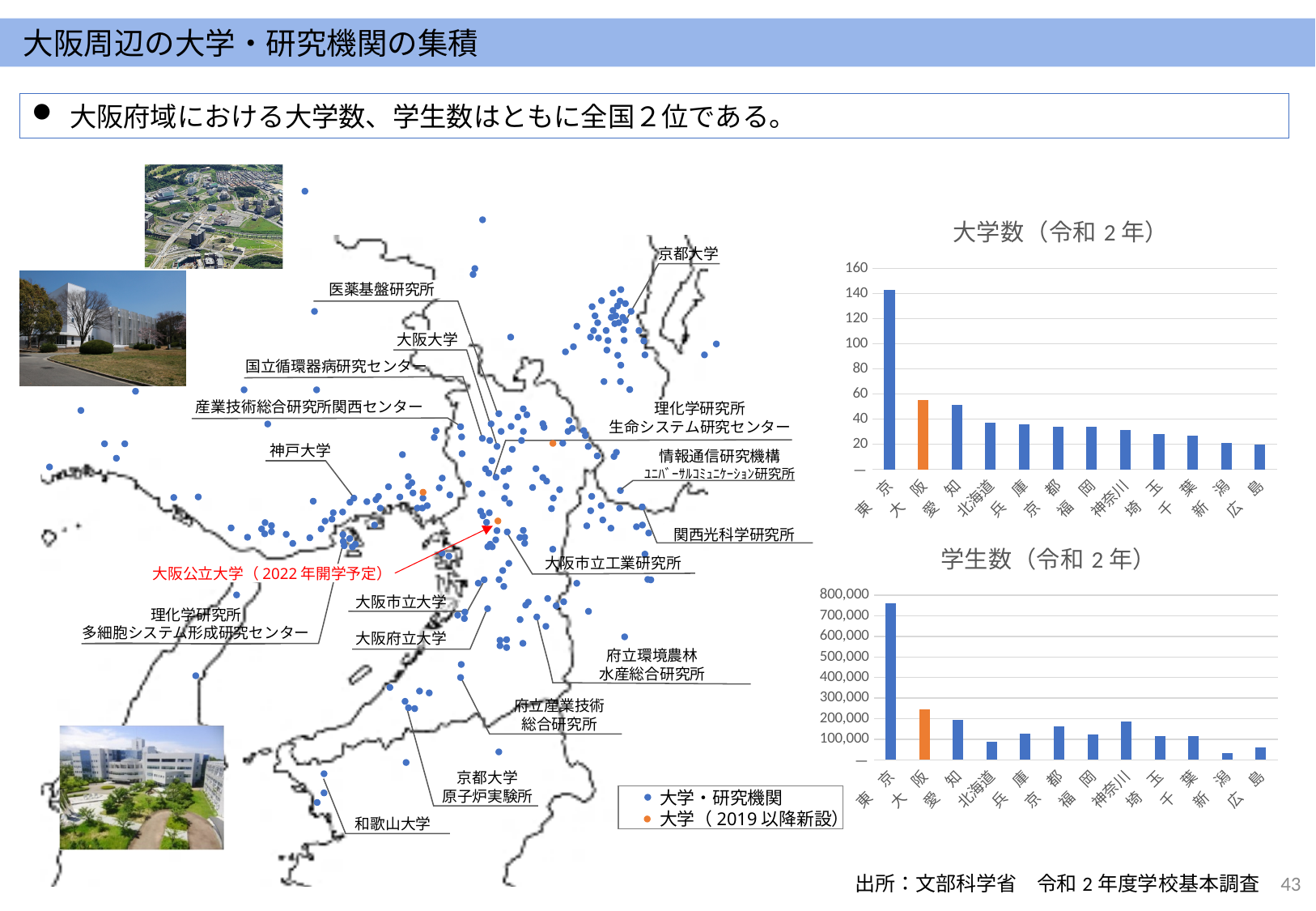
How many prefectures are shown on the x axis of the 学生数（令和2年） chart? 12 What kind of chart is the 大学数（令和2年） chart? bar chart In the 大学数（令和2年） chart, is the value for 東京 greater or less than 120? greater In the 大学数（令和2年） chart, which prefecture has the highest value? 東京 In the 大学数（令和2年） chart, do the values generally rise or fall from left to right along the x axis? fall In the 大学数（令和2年） chart, is the value for 大阪 greater or less than 40? greater In the 学生数（令和2年） chart, which is larger, the value for 大阪 or the value for 愛知? 大阪 In the 大学数（令和2年） chart, which prefecture's bar is coloured orange? 大阪 In the 学生数（令和2年） chart, is the value for 東京 greater or less than 700,000? greater In the 学生数（令和2年） chart, which prefecture has the lowest value? 新潟 In the 学生数（令和2年） chart, which prefecture has the highest value? 東京